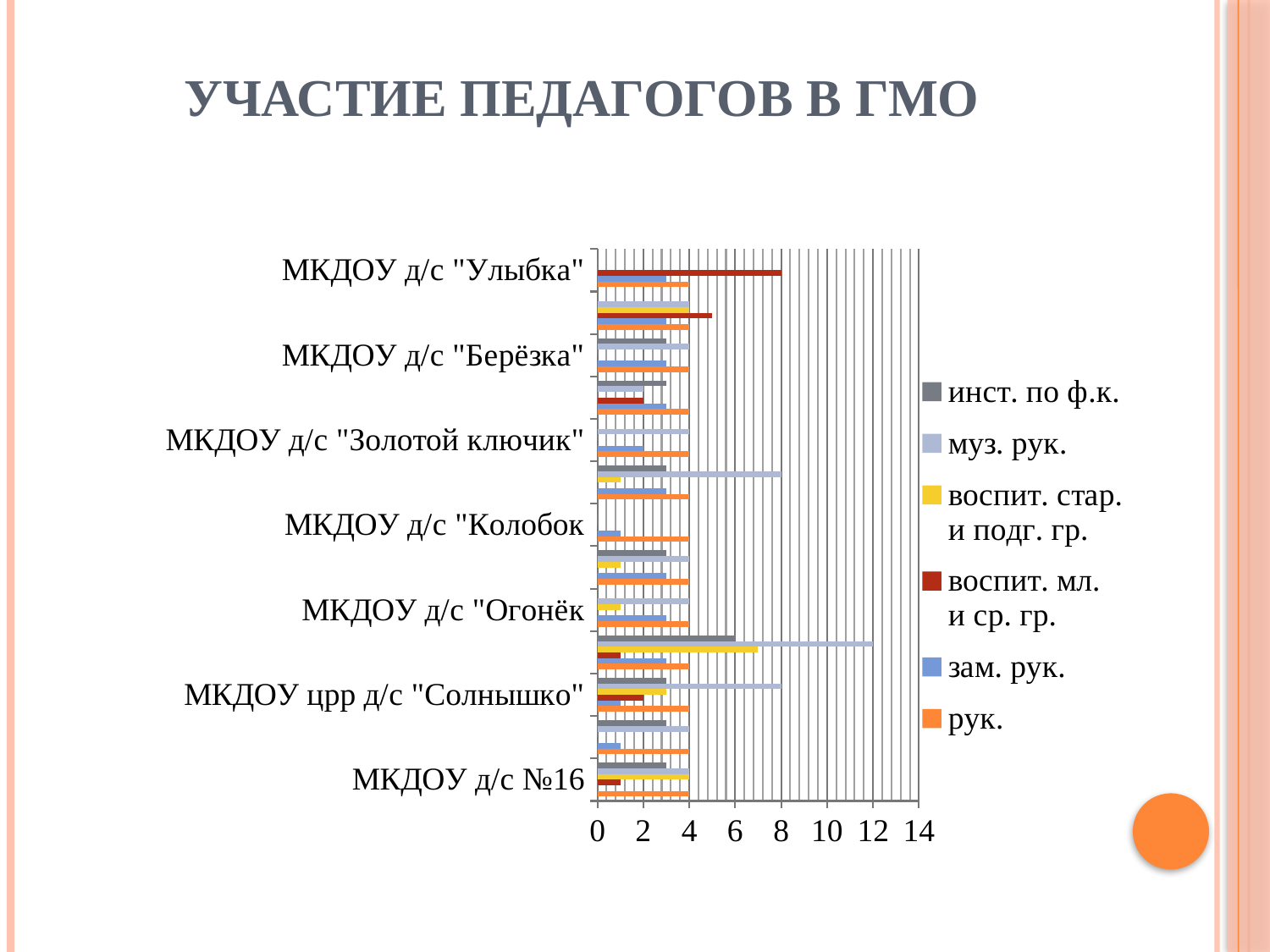
Is the value for воспит. мл. и ср. гр. at МКДОУ д/с №16 greater or less than 4? less Which series is listed last in the legend? рук. What is the title of the slide's chart? УЧАСТИЕ ПЕДАГОГОВ В ГМО At МКДОУ црр д/с "Солнышко", which is larger: муз. рук. or зам. рук.? муз. рук. How many series does the legend list? 6 How many category labels are shown on the vertical axis? 7 What kind of chart is shown on the slide? bar chart Is the value for муз. рук. at МКДОУ црр д/с "Солнышко" greater or less than 6? greater At МКДОУ д/с "Улыбка", which is larger: воспит. мл. и ср. гр. or рук.? воспит. мл. и ср. гр. Which series has the longest bar anywhere on the chart? муз. рук. Is the value for воспит. мл. и ср. гр. at МКДОУ д/с "Улыбка" greater or less than 6? greater